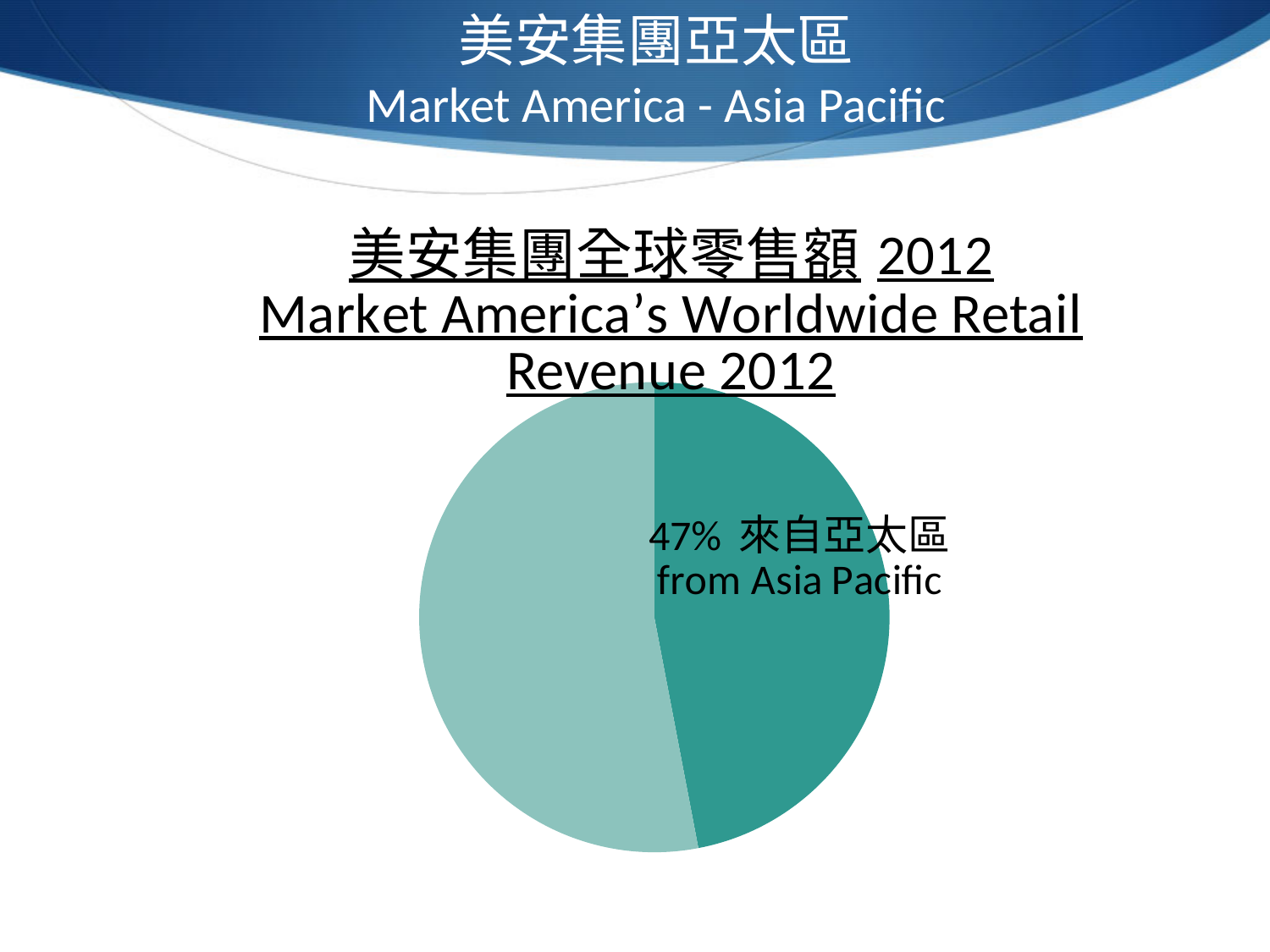
Is the Asia Pacific share of the pie greater or less than 50%? less What share of Market America's Worldwide Retail Revenue 2012 comes from Asia Pacific? 47% What kind of chart is shown on the slide? Pie chart How many slices does the pie chart have? 2 Which slice is larger: the Asia Pacific slice or the remaining slice? The remaining slice Is the share of the slice not from Asia Pacific greater or less than 50%? greater Which slice of the pie is the smallest? Asia Pacific What is the title of the pie chart in English? Market America's Worldwide Retail Revenue 2012 Which year does the pie chart's revenue data refer to? 2012